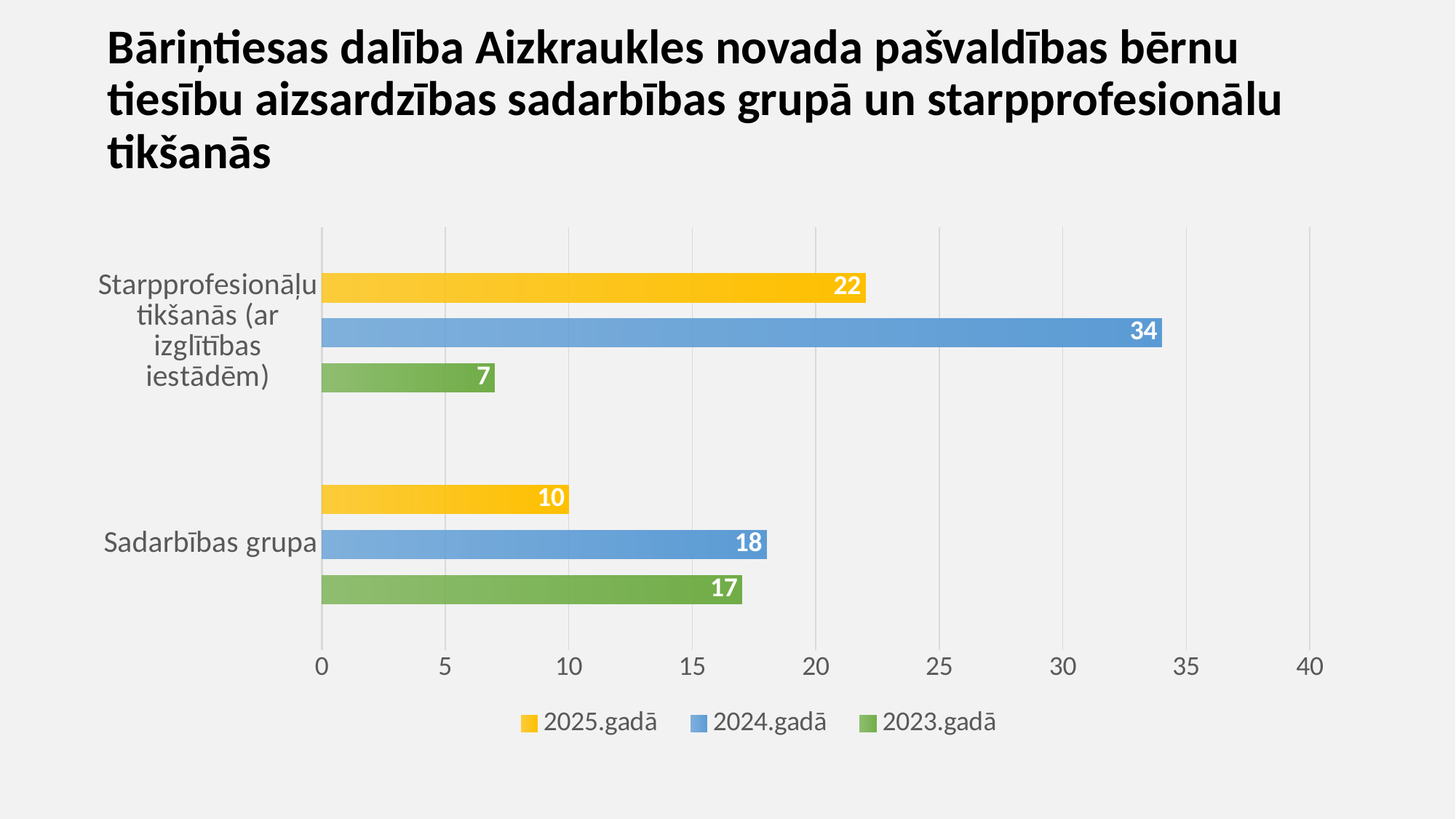
What is the value for Sadarbības grupa in 2023.gadā? 17 What is the value for Starpprofesionāļu tikšanās (ar izglītības iestādēm) in 2023.gadā? 7 What is the difference between the 2024.gadā and 2025.gadā values for Starpprofesionāļu tikšanās (ar izglītības iestādēm)? 12 Which colour represents 2023.gadā in the legend? Green What is the value for Sadarbības grupa in 2025.gadā? 10 How many series does the legend list? 3 What kind of chart is shown on the slide? Bar chart Which year has the lowest value for Sadarbības grupa? 2025.gadā Which year has the highest value for Starpprofesionāļu tikšanās (ar izglītības iestādēm)? 2024.gadā How many categories are shown on the chart? 2 What is the value for Starpprofesionāļu tikšanās (ar izglītības iestādēm) in 2024.gadā? 34 Which is larger: the 2024.gadā value for Sadarbības grupa or the 2023.gadā value for Sadarbības grupa? 2024.gadā